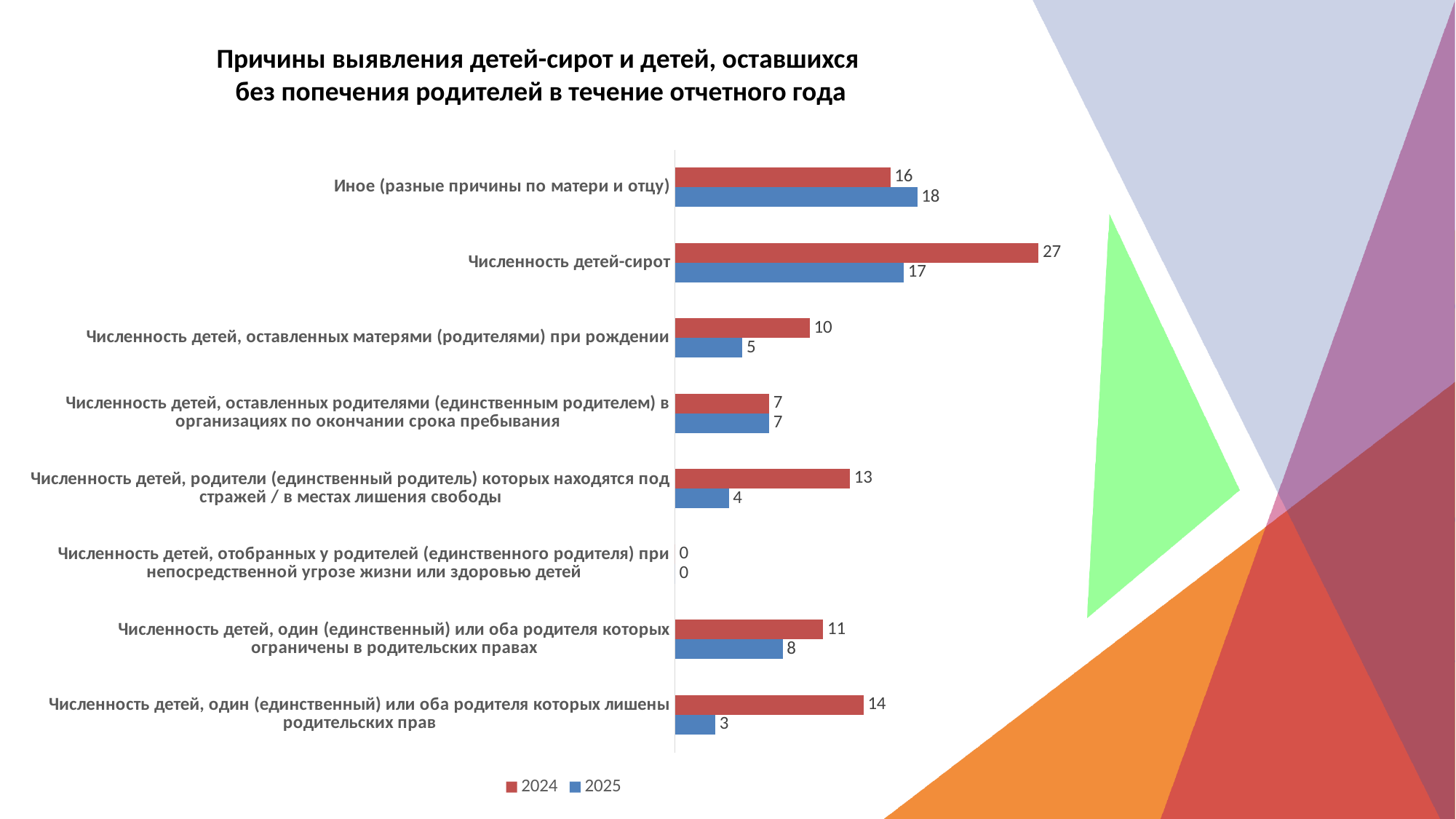
Which colour represents the 2025 series in the legend? Blue What is the 2024 value for "Численность детей-сирот"? 27 Which category has the highest 2024 value? Численность детей-сирот What is the 2025 value for "Численность детей, один (единственный) или оба родителя которых лишены родительских прав"? 3 Which category has the lowest 2025 value? Численность детей, отобранных у родителей (единственного родителя) при непосредственной угрозе жизни или здоровью детей How many series does the legend list? 2 What is the 2025 value for "Иное (разные причины по матери и отцу)"? 18 Which is larger for "Иное (разные причины по матери и отцу)": the 2024 value or the 2025 value? 2025 What is the difference between the 2024 and 2025 values for "Численность детей, родители (единственный родитель) которых находятся под стражей / в местах лишения свободы"? 9 What is the difference between the 2024 and 2025 values for "Численность детей-сирот"? 10 What kind of chart is shown on the slide? Bar chart How many categories are shown on the chart? 8